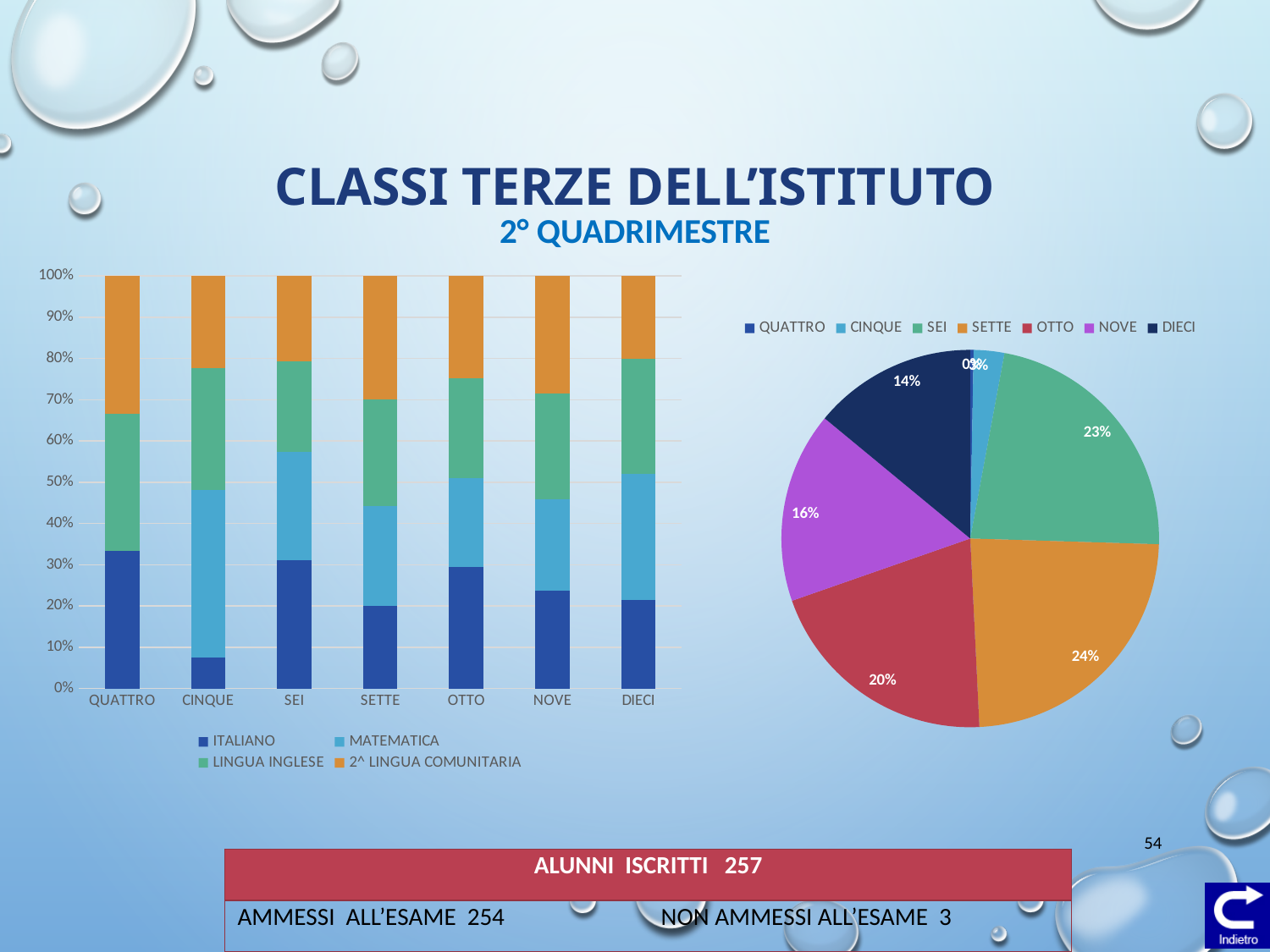
In the pie chart on the right, which category has the largest slice? SETTE In the bar chart on the left, how many series does the legend list? 4 In the pie chart on the right, what is the share for DIECI? 14% In the pie chart on the right, how many entries does the legend list? 7 In the pie chart on the right, what is the share for OTTO? 20% In the bar chart on the left, is the ITALIANO value for CINQUE greater or less than 10%? less In the bar chart on the left, how many categories are shown on the x axis? 7 What kind of chart is the chart on the right side of the slide? Pie chart In the pie chart on the right, what is the share for NOVE? 16% In the pie chart on the right, which slice is larger, OTTO or NOVE? OTTO What kind of chart is the chart on the left side of the slide? Stacked bar chart In the bar chart on the left, is the ITALIANO value for QUATTRO greater or less than 30%? greater